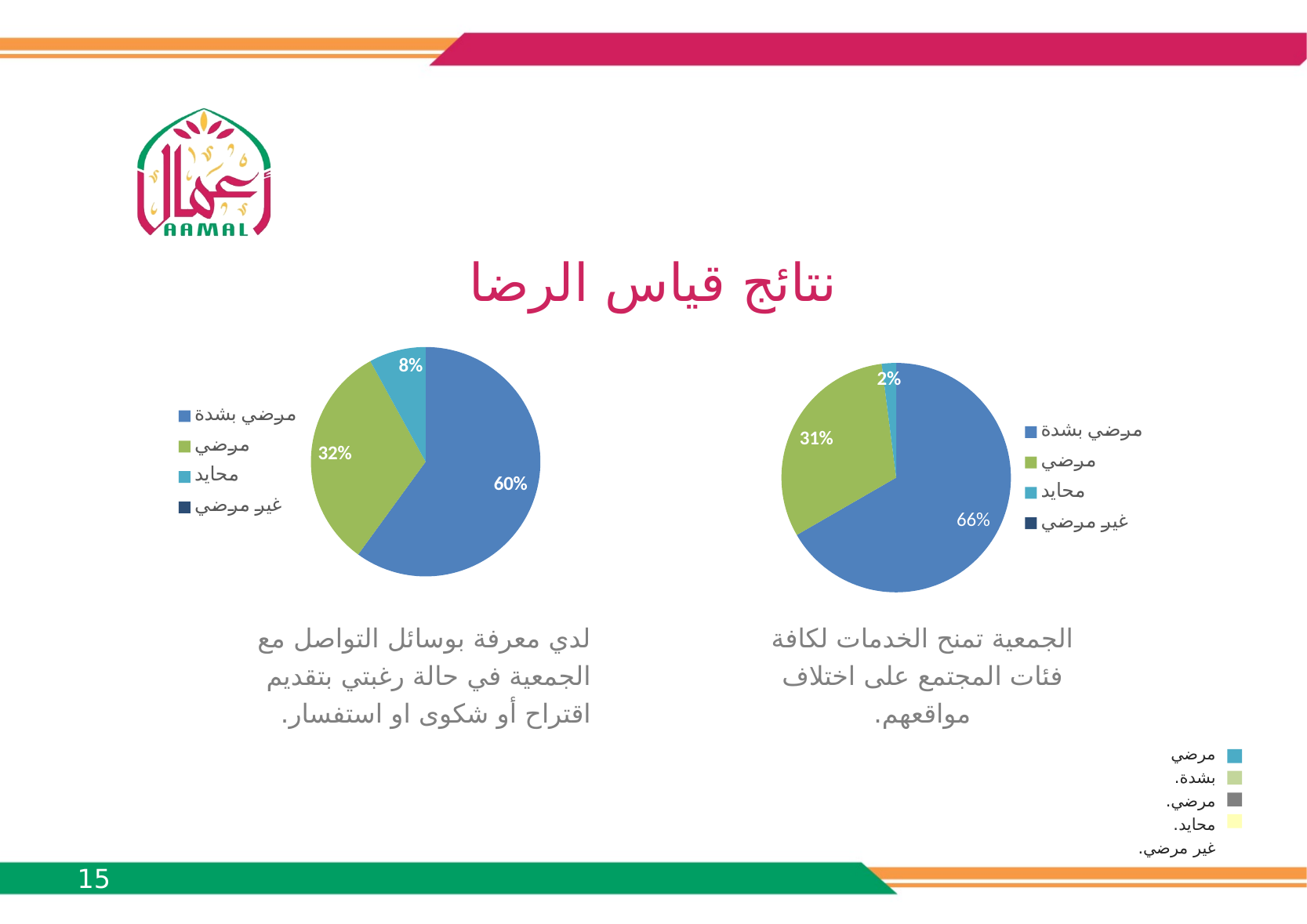
In the left pie chart, what percentage is shown for محايد? 8% How many entries does the legend of the right pie chart list? 4 Which is larger: the مرضي بشدة share in the left pie chart or in the right pie chart? the right pie chart What type of chart is used on the left side of the slide? pie chart In the right pie chart, what percentage is shown for مرضي? 31% In the right pie chart, what percentage is shown for محايد? 2% In the left pie chart, which labelled category has the smallest slice? محايد In the left pie chart, what percentage is shown for مرضي بشدة? 60% In the right pie chart, what percentage is shown for مرضي بشدة? 66% In the right pie chart, which category has the largest slice? مرضي بشدة In the left pie chart, what percentage is shown for مرضي? 32% In the left pie chart, what is the difference between the مرضي بشدة and مرضي percentages? 28%